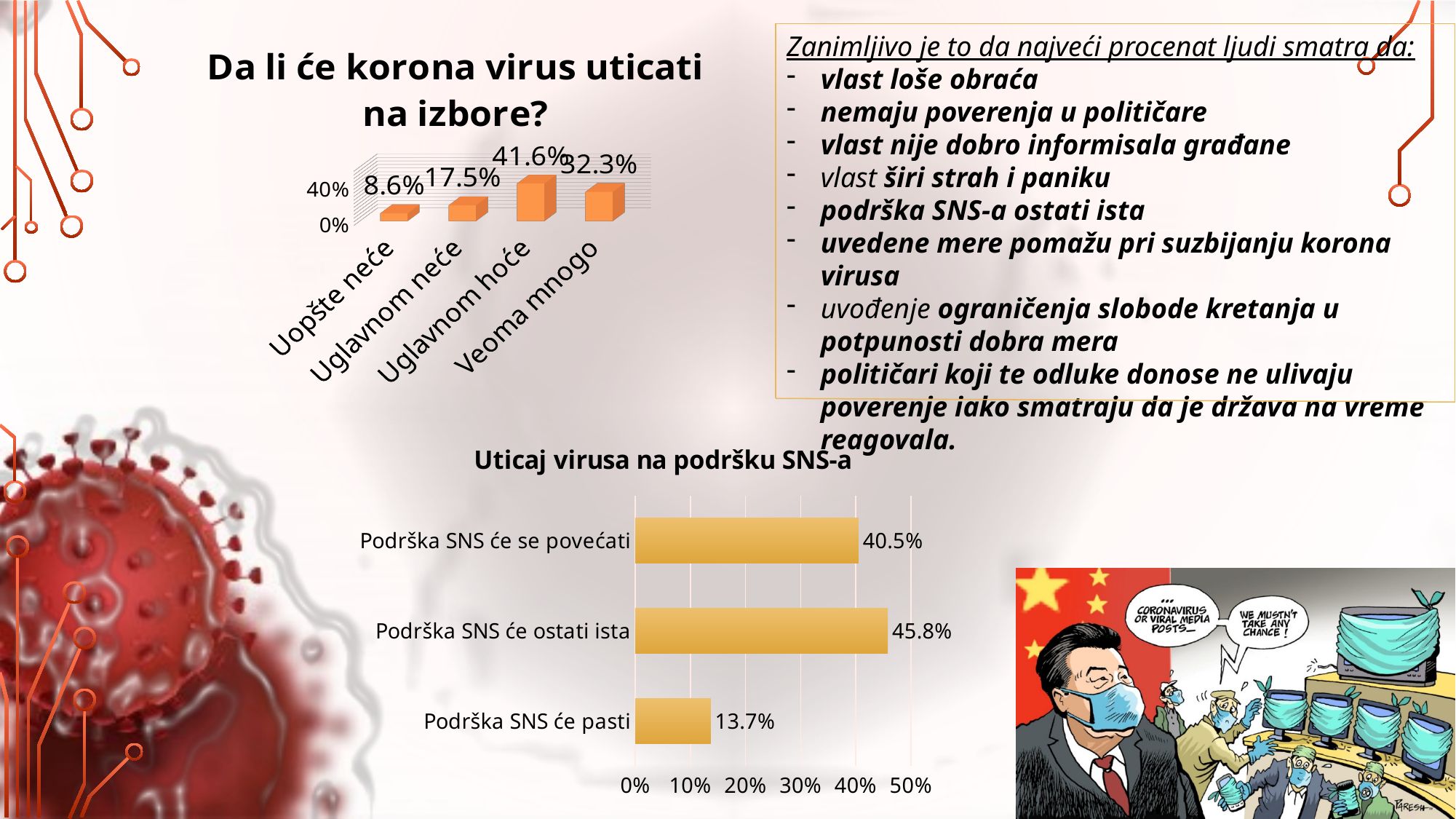
In the chart 'Da li će korona virus uticati na izbore?', what is the value for 'Uglavnom hoće'? 41.6% In the chart 'Da li će korona virus uticati na izbore?', how many categories are shown? 4 In the chart 'Da li će korona virus uticati na izbore?', what is the value for 'Uopšte neće'? 8.6% In the chart 'Uticaj virusa na podršku SNS-a', which is larger: 'Podrška SNS će se povećati' or 'Podrška SNS će pasti'? Podrška SNS će se povećati In the chart 'Da li će korona virus uticati na izbore?', which category has the lowest value? Uopšte neće In the chart 'Uticaj virusa na podršku SNS-a', what is the difference between 'Podrška SNS će ostati ista' and 'Podrška SNS će se povećati'? 5.3% In the chart 'Uticaj virusa na podršku SNS-a', which category has the highest value? Podrška SNS će ostati ista In the chart 'Uticaj virusa na podršku SNS-a', what is the value for 'Podrška SNS će pasti'? 13.7% In the chart 'Da li će korona virus uticati na izbore?', what is the difference between 'Veoma mnogo' and 'Uglavnom neće'? 14.8% In the chart 'Da li će korona virus uticati na izbore?', which category has the highest value? Uglavnom hoće What kind of chart is 'Uticaj virusa na podršku SNS-a'? Bar chart In the chart 'Uticaj virusa na podršku SNS-a', what is the value for 'Podrška SNS će ostati ista'? 45.8%